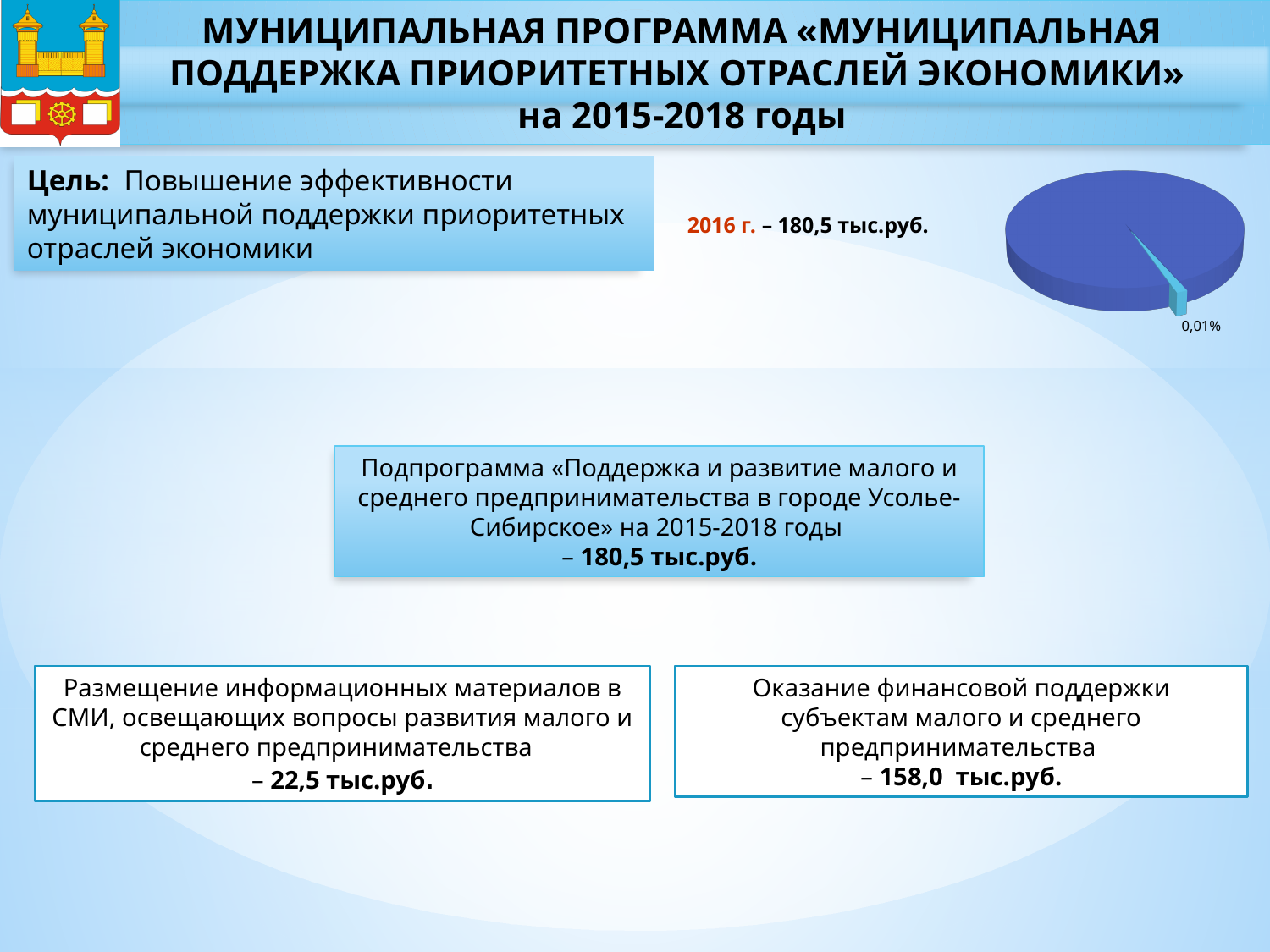
Does the pie chart have a legend? No Which slice of the pie chart is larger, the dark blue one or the small light-blue one? the dark blue one What kind of chart is shown on the slide? pie chart What percentage is printed next to the small slice of the pie chart? 0,01% What share of the pie does the small light-blue slice represent, according to its label? 0,01% How many slices does the pie chart have? 2 What colour is the largest slice of the pie chart? dark blue